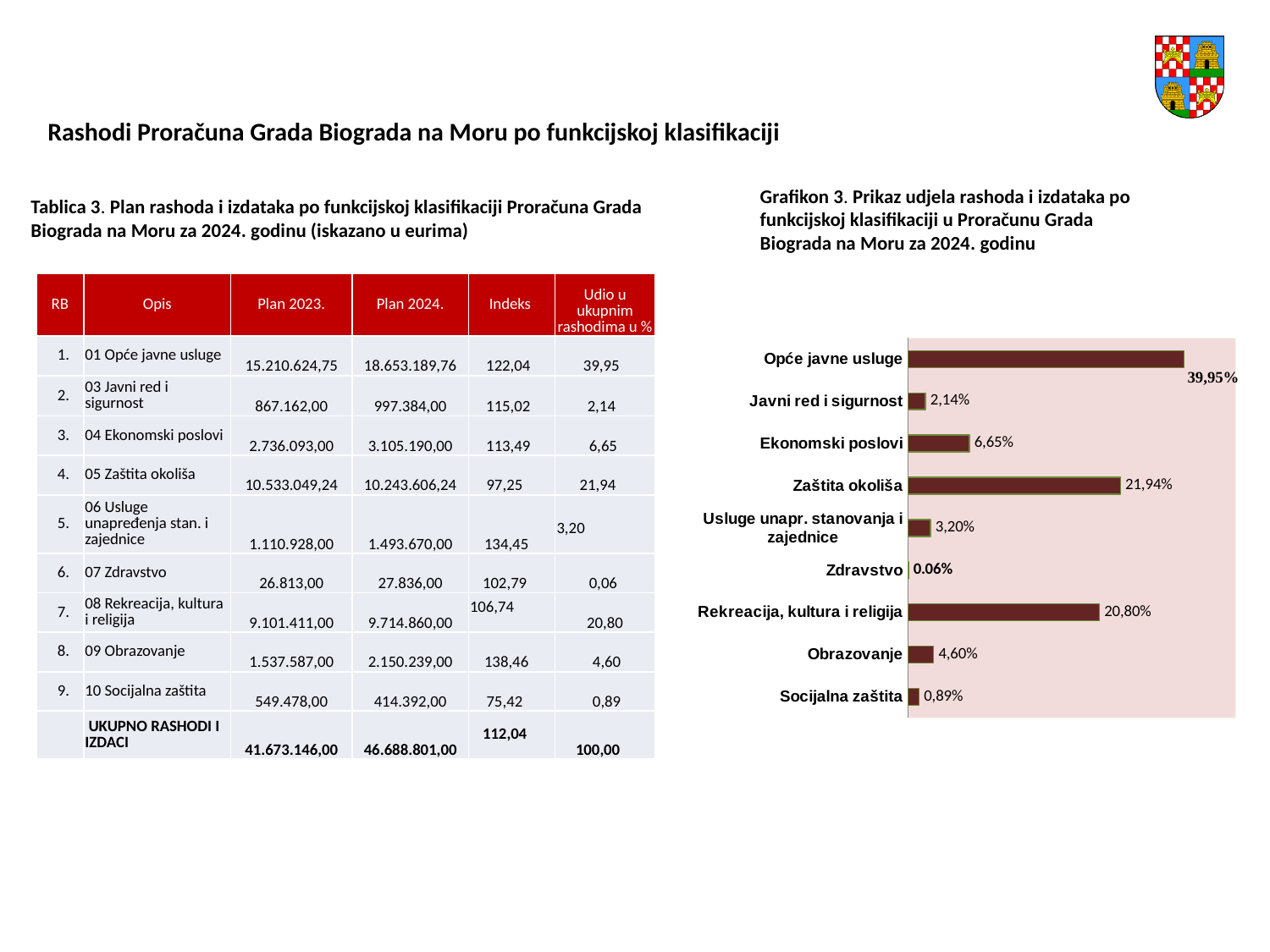
What is the value shown for Zaštita okoliša in the chart? 21,94% What is the value shown for Rekreacija, kultura i religija in the chart? 20,80% Which category has the lowest value in the chart? Zdravstvo What is the difference between the values for Opće javne usluge and Zaštita okoliša? 18,01% Which is larger, the value for Zaštita okoliša or the value for Rekreacija, kultura i religija? Zaštita okoliša What type of chart is shown on the slide? Bar chart Which category has the highest value in the chart? Opće javne usluge How many categories are shown in the chart? 9 What is the value shown for Opće javne usluge in the chart? 39,95% What is the value shown for Usluge unapr. stanovanja i zajednice in the chart? 3,20% What is the difference between the values for Ekonomski poslovi and Obrazovanje? 2,05% What is the value shown for Zdravstvo in the chart? 0.06%